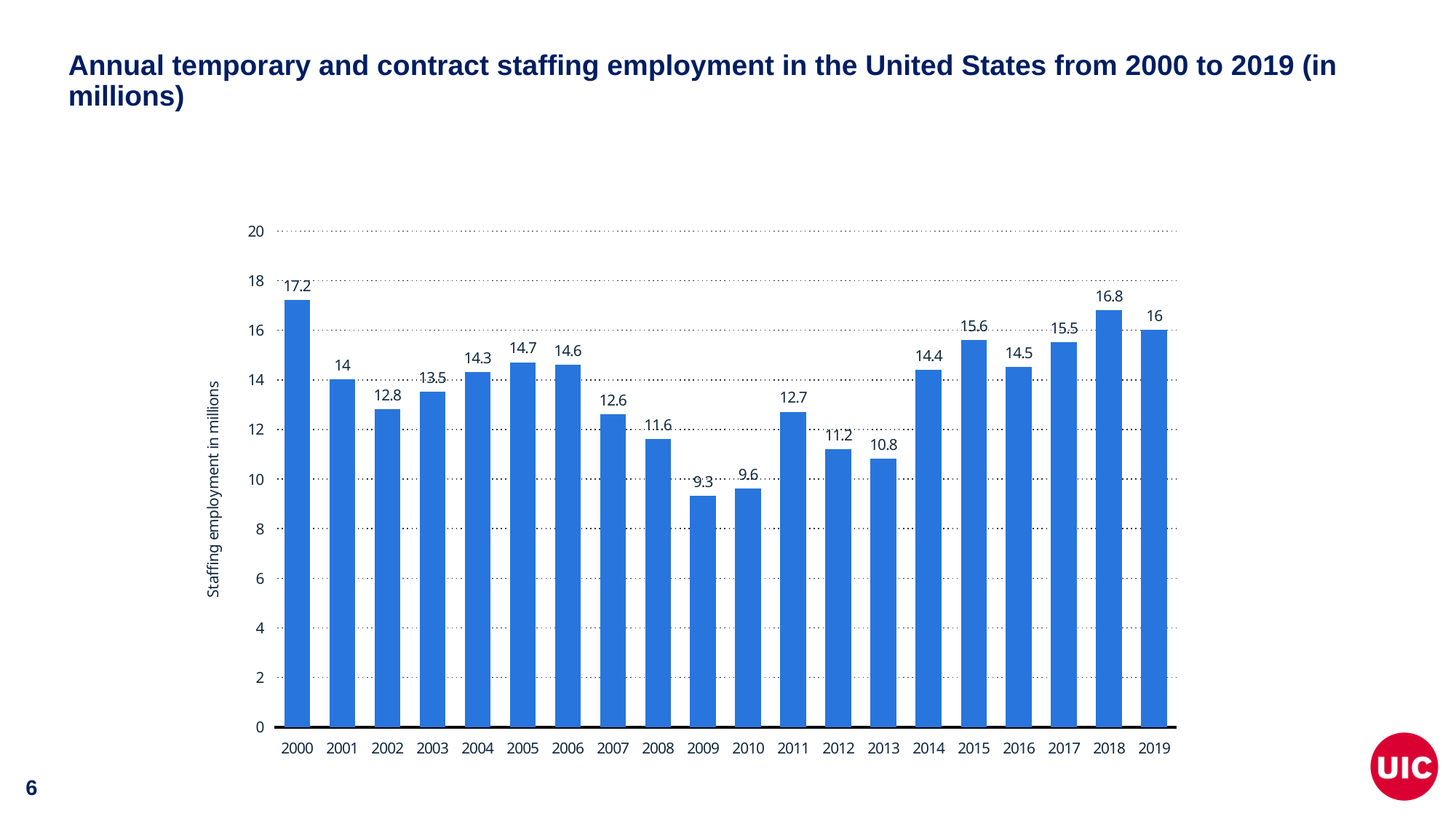
What is the difference in staffing employment between 2000 and 2009? 7.9 What was the staffing employment in 2000? 17.2 What is the label of the vertical axis? Staffing employment in millions What was the staffing employment in 2019? 16 Which year had the highest staffing employment? 2000 Which year had higher staffing employment, 2005 or 2006? 2005 Which year had the lowest staffing employment? 2009 How many years are shown on the chart? 20 What kind of chart is shown on the slide? Bar chart What was the staffing employment in 2009? 9.3 What is the difference in staffing employment between 2018 and 2019? 0.8 Is the value for 2013 greater or less than 12? less